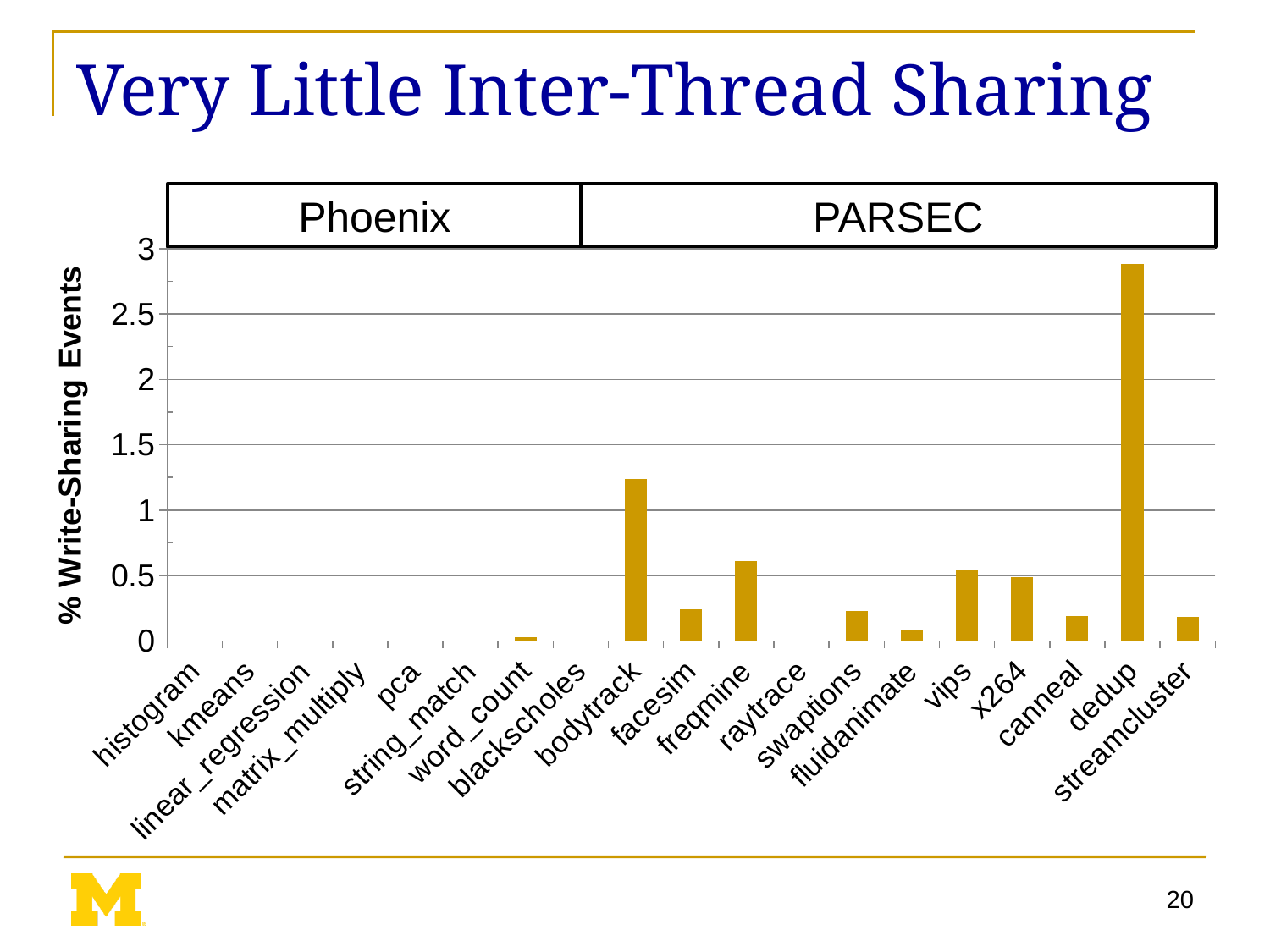
Is the value for dedup greater or less than 2.5? greater What kind of chart is shown on the slide? bar chart Which has a larger % Write-Sharing Events, bodytrack or freqmine? bodytrack What are the two benchmark suite groups labelled above the chart? Phoenix and PARSEC Is the value for freqmine greater or less than 0.5? greater Which has a larger % Write-Sharing Events, vips or facesim? vips Is the value for fluidanimate greater or less than 0.5? less Which benchmark has the highest % Write-Sharing Events? dedup How many benchmarks are plotted along the x axis? 19 What is the label on the y axis? % Write-Sharing Events